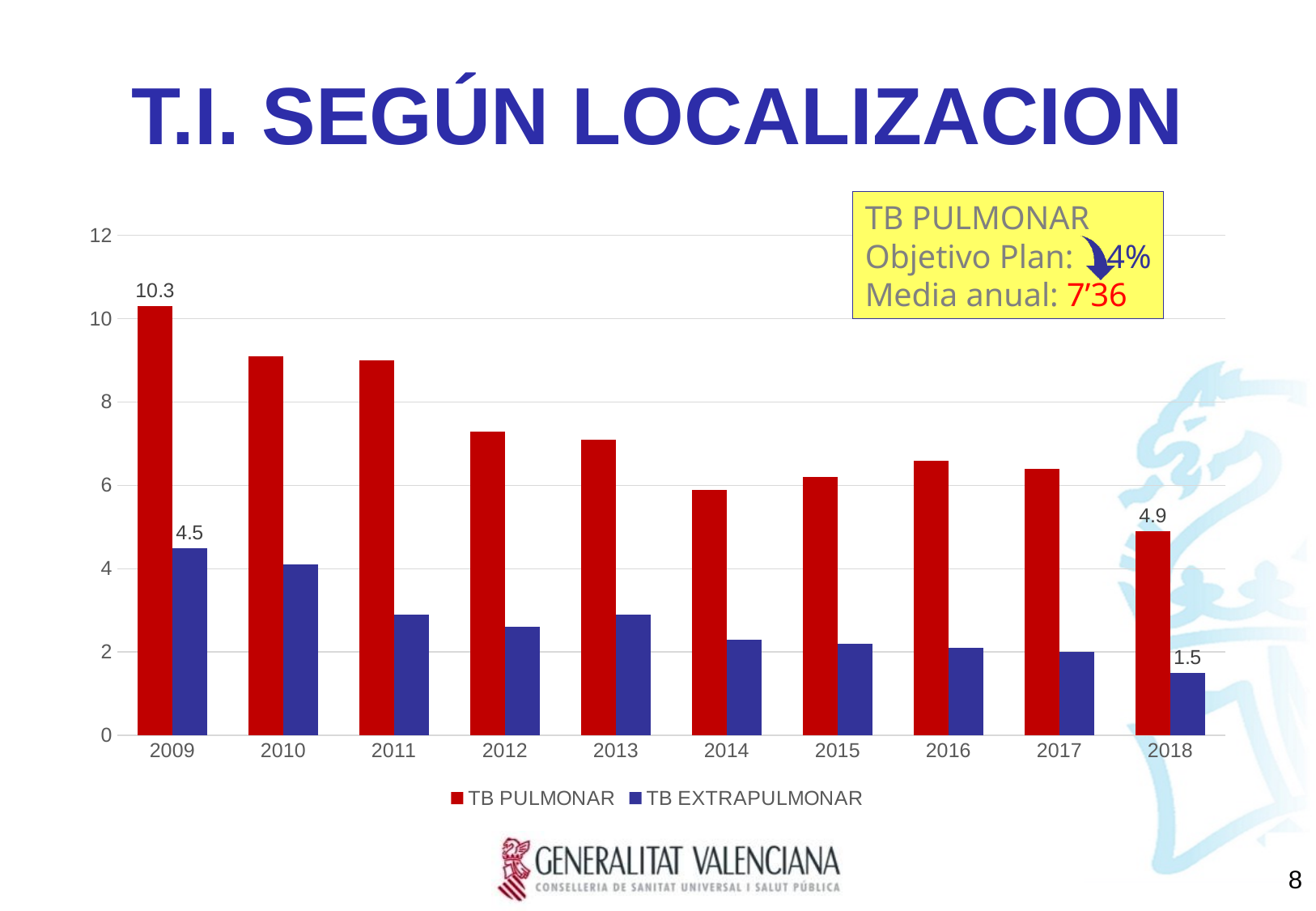
Is the value for TB PULMONAR in 2010 greater or less than 8? greater By how much did the TB PULMONAR value fall from 2009 to 2018? 5.4 What kind of chart is shown on the slide? bar chart Which year has the highest TB PULMONAR value? 2009 What is the value for TB PULMONAR in 2018? 4.9 Which year has the lowest TB EXTRAPULMONAR value? 2018 What is the value for TB PULMONAR in 2009? 10.3 In 2009, which series has the larger value, TB PULMONAR or TB EXTRAPULMONAR? TB PULMONAR How many years are shown on the x axis? 10 How many series does the legend list? 2 What is the value for TB EXTRAPULMONAR in 2018? 1.5 What is the value for TB EXTRAPULMONAR in 2009? 4.5